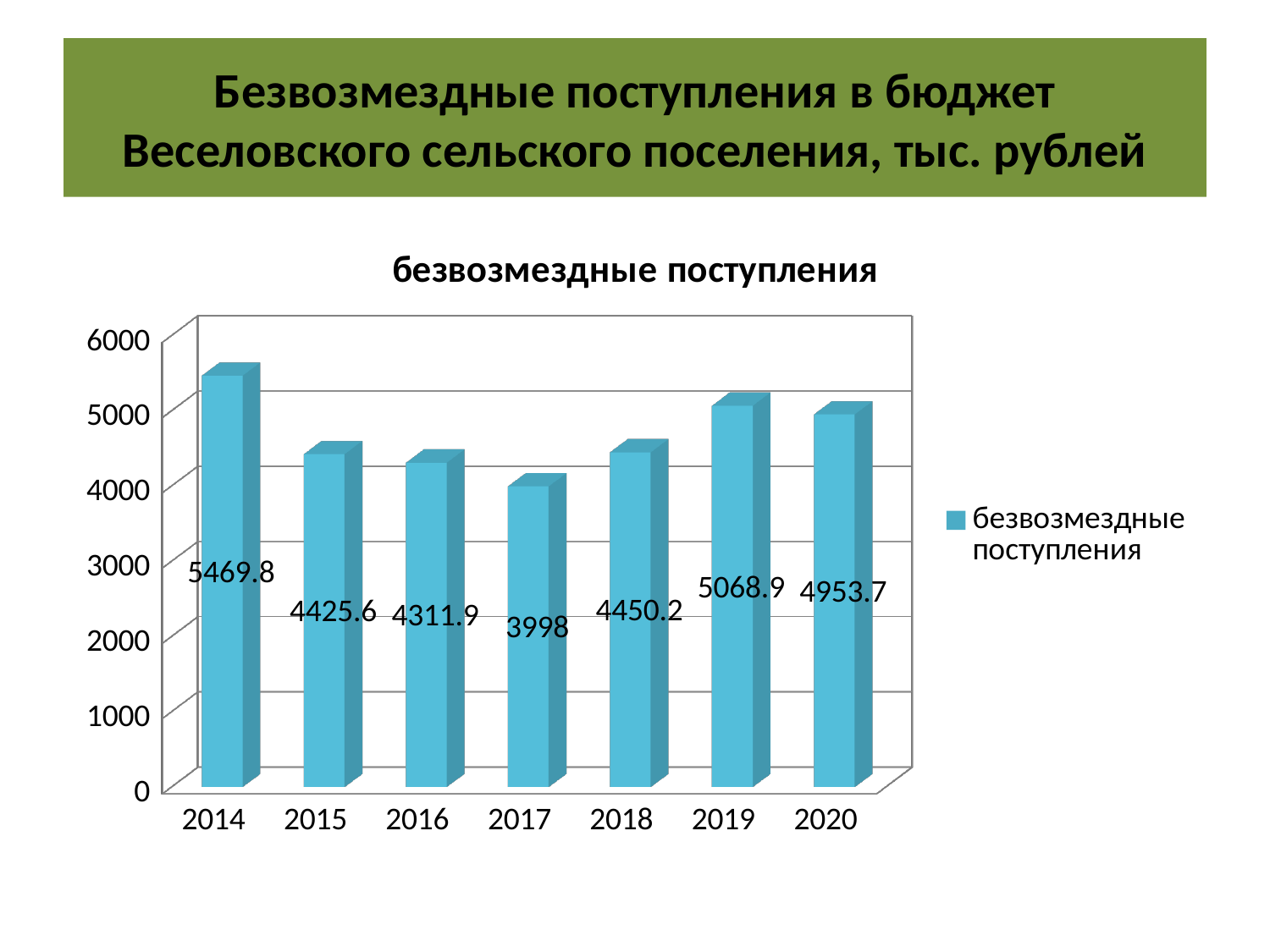
What kind of chart is shown? bar chart Which year has the lowest value? 2017 What is the value for 2014? 5469.8 What is the title of the chart? безвозмездные поступления Is the value for 2019 greater or less than 5000? greater Which year has the highest value? 2014 What is the value for 2017? 3998 Which is larger, the value for 2015 or the value for 2016? 2015 What is the difference between the values for 2019 and 2018? 618.7 How many series does the legend list? 1 How many years are shown on the x axis? 7 What is the value for 2020? 4953.7